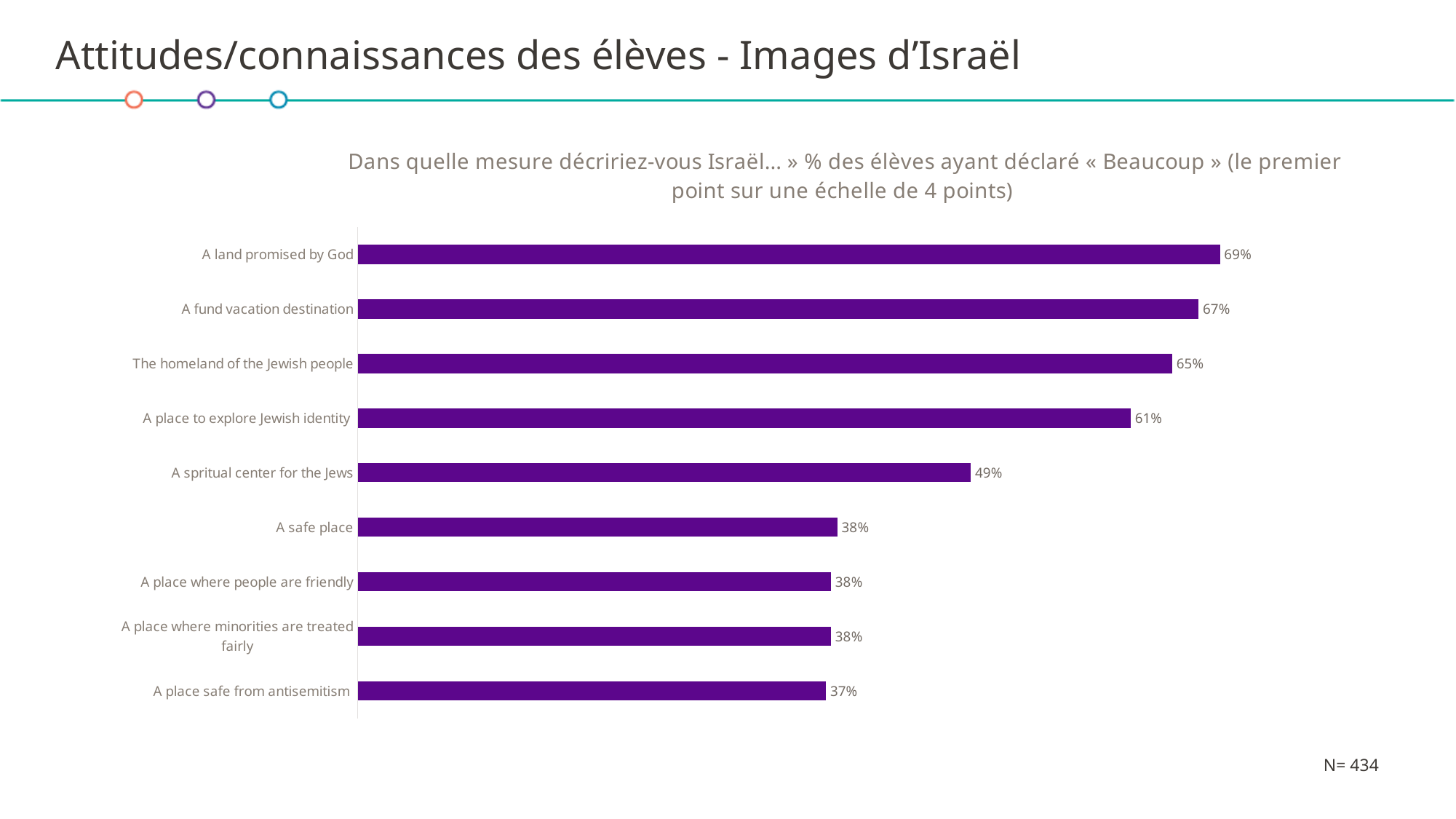
What is the value for 'A place safe from antisemitism'? 37% What percentage of students described Israel as 'A land promised by God' a lot? 69% Which is larger: 'A fund vacation destination' or 'A place where people are friendly'? A fund vacation destination What type of chart is shown on the slide? Bar chart What is the value for 'A spritual center for the Jews'? 49% Which category has the highest value? A land promised by God Which category has the lowest value? A place safe from antisemitism What is the difference between 'The homeland of the Jewish people' and 'A spritual center for the Jews'? 16% What is the sample size (N) shown on the slide? 434 What is the value for 'A place to explore Jewish identity'? 61% How many categories are shown in the chart? 9 What is the difference between 'A land promised by God' and 'A safe place'? 31%